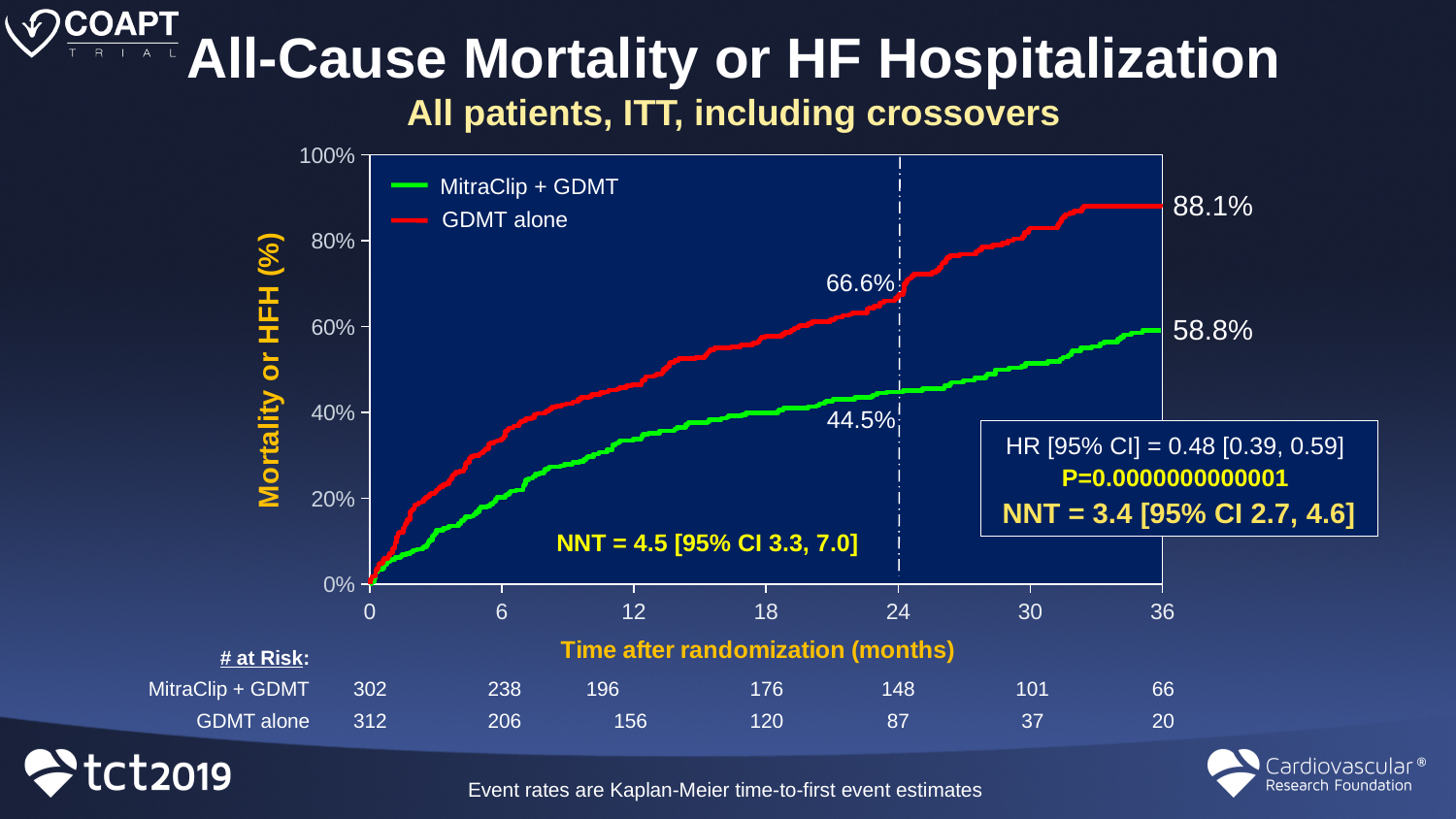
Which group has the higher event rate at 24 months, MitraClip + GDMT or GDMT alone? GDMT alone What kind of chart is shown on the slide? Line chart (Kaplan-Meier curve) How many series does the legend list? 2 What is the event rate for MitraClip + GDMT at 24 months? 44.5% How many patients in the GDMT alone group were at risk at 24 months? 87 Which colour represents the MitraClip + GDMT curve? Green Do the event rates rise or fall as time after randomization increases? Rise What is the event rate for GDMT alone at 36 months? 88.1% What is the difference between the GDMT alone and MitraClip + GDMT event rates at 24 months? 22.1 percentage points What is the event rate for MitraClip + GDMT at 36 months? 58.8% What is the difference between the GDMT alone and MitraClip + GDMT event rates at 36 months? 29.3 percentage points What is the event rate for GDMT alone at 24 months? 66.6%